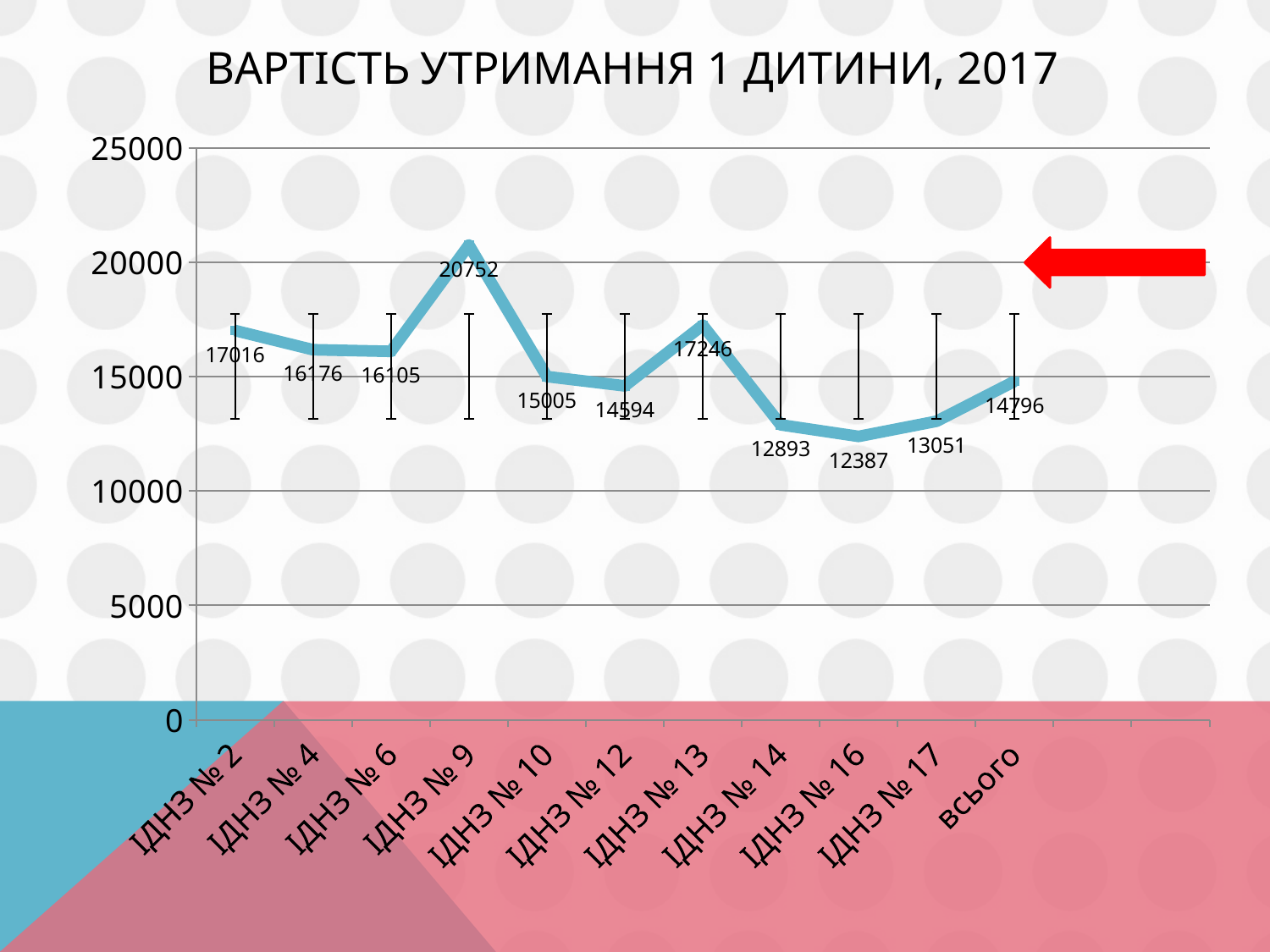
What kind of chart is shown on the slide? line chart Is the value for ІДНЗ № 14 greater or less than 15000? less Which category has the lowest value? ІДНЗ № 16 What is the value for ІДНЗ № 16? 12387 What is the difference between the values for ІДНЗ № 9 and ІДНЗ № 16? 8365 What is the value for ІДНЗ № 13? 17246 What is the value for ІДНЗ № 9? 20752 Which is larger, the value for ІДНЗ № 13 or the value for ІДНЗ № 10? ІДНЗ № 13 Which category has the highest value? ІДНЗ № 9 What is the value shown for всього? 14796 How many categories are shown on the x axis? 11 What is the difference between the values for ІДНЗ № 2 and ІДНЗ № 4? 840